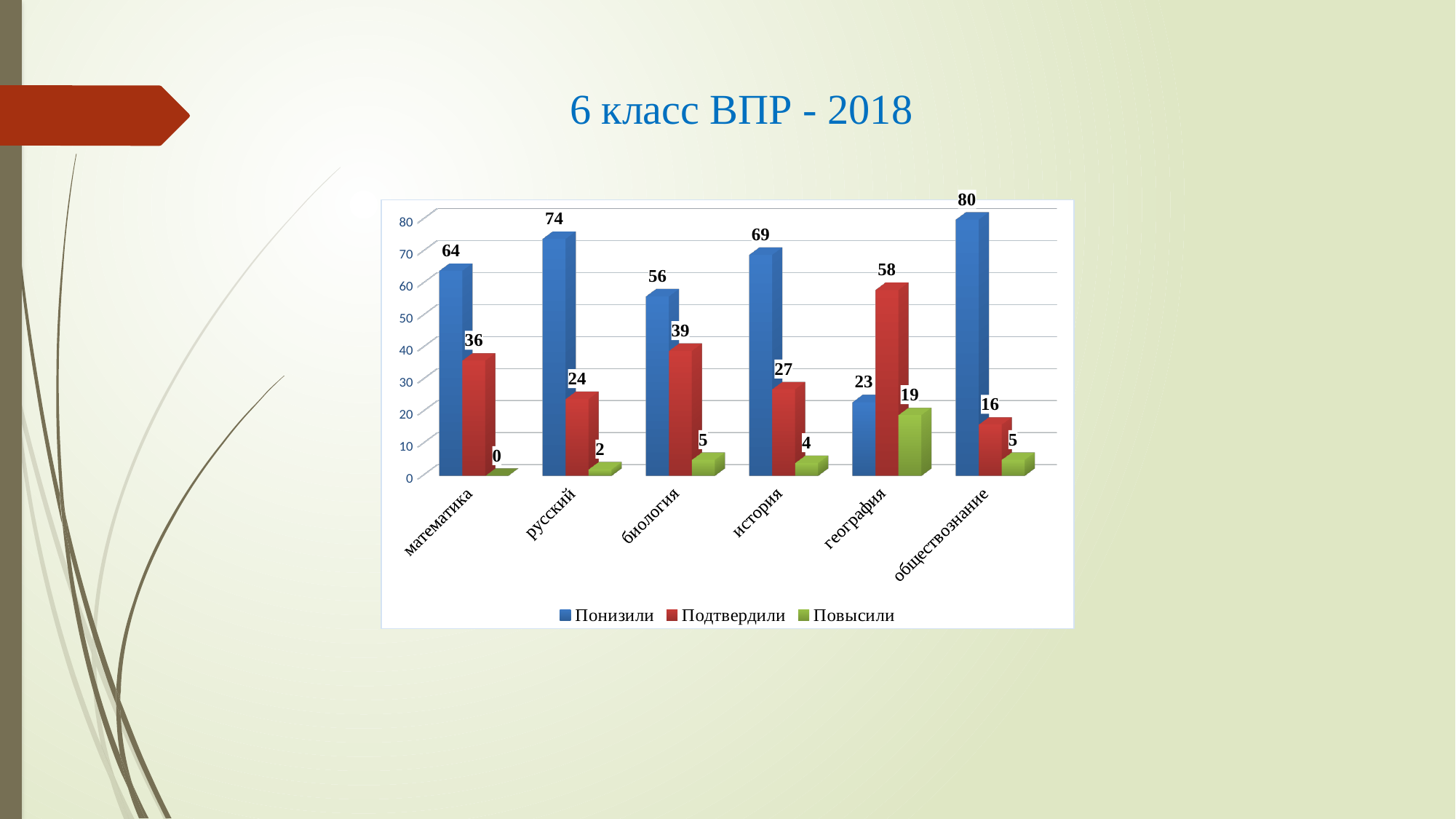
What is the value of Понизили for математика? 64 What is the title of the slide? 6 класс ВПР - 2018 Which subject has the lowest Повысили value? математика Which subject has the highest Понизили value? обществознание How many subjects are shown on the x axis? 6 What is the value of Повысили for обществознание? 5 Which colour represents the Повысили series? green What kind of chart is shown on the slide? bar chart What is the difference between the Понизили and Подтвердили values for русский? 50 What is the value of Подтвердили for география? 58 Which is larger for география: Понизили or Подтвердили? Подтвердили How many series does the legend list? 3